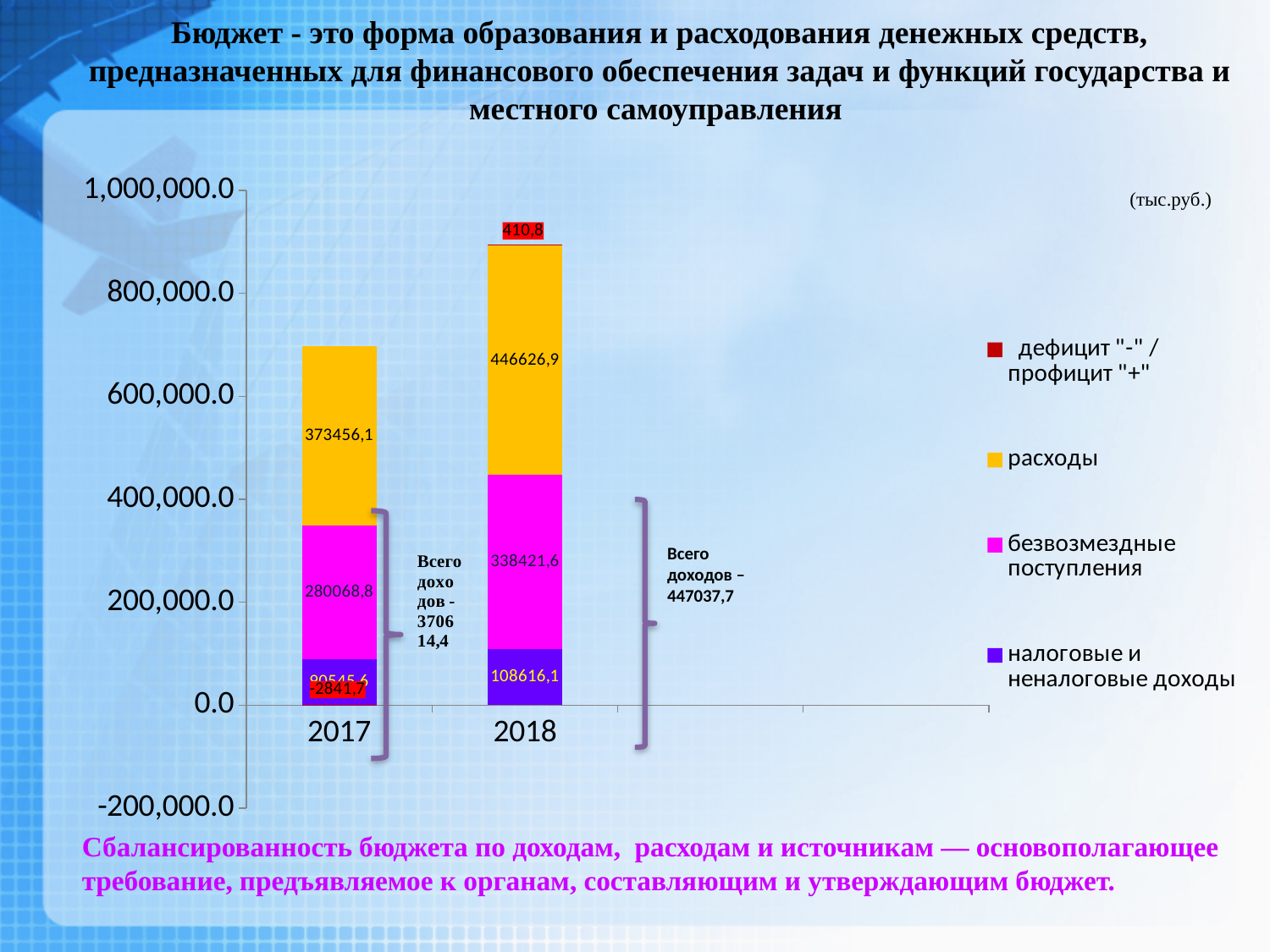
What kind of chart is shown on the slide? Stacked bar chart What is the value of безвозмездные поступления for 2017? 280068,8 What is the difference between расходы in 2018 and in 2017? 73170,8 What is the value of расходы for 2018? 446626,9 How many series does the legend list? 4 What is the value of дефицит/профицит for 2017? -2841,7 Which year has the larger value for расходы, 2017 or 2018? 2018 What is the difference between безвозмездные поступления in 2018 and in 2017? 58352,8 What is the value of расходы for 2017? 373456,1 What is the value of безвозмездные поступления for 2018? 338421,6 What is the value of дефицит/профицит for 2018? 410,8 What is the value of налоговые и неналоговые доходы for 2018? 108616,1